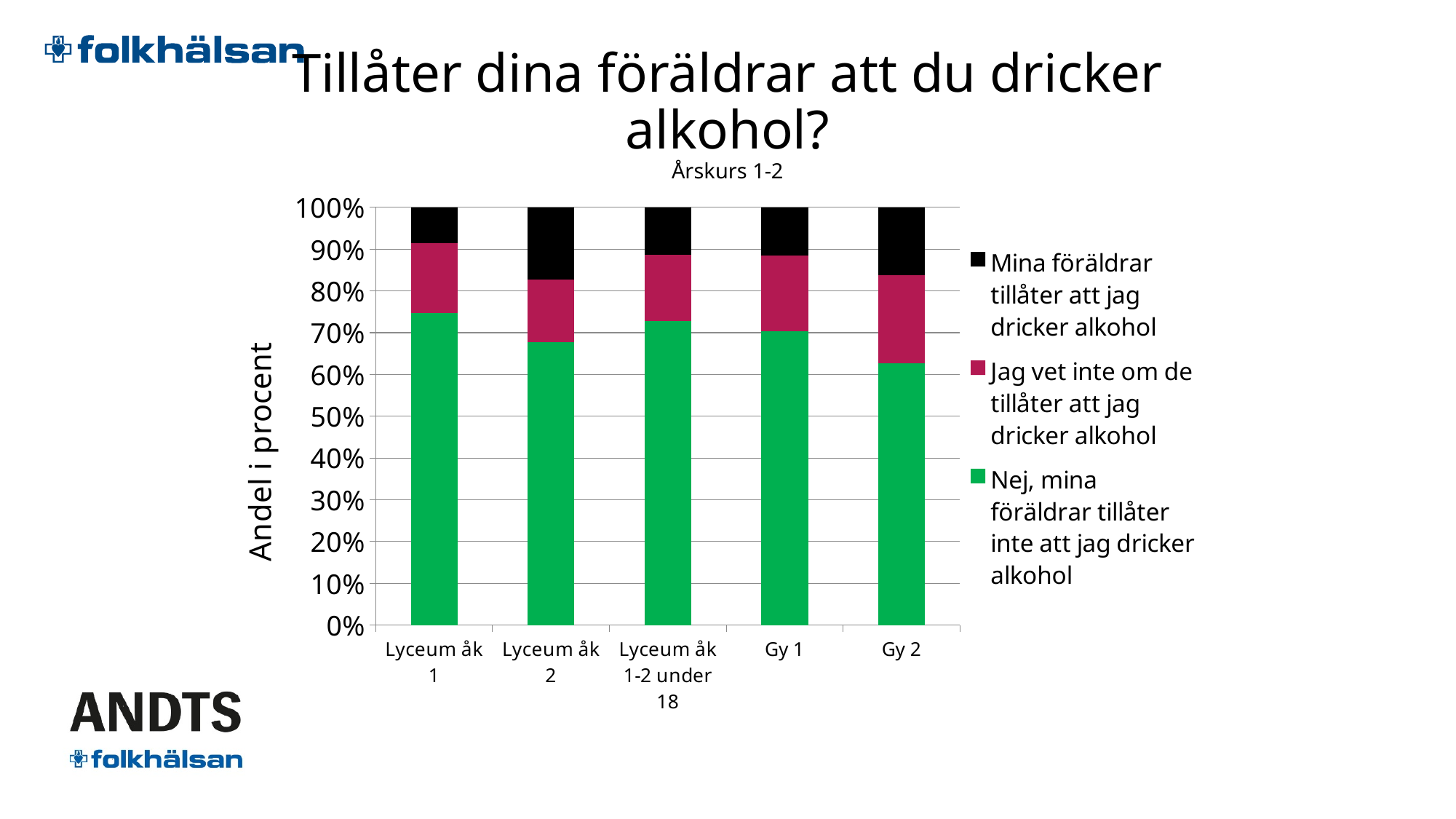
Which is larger for 'Mina föräldrar tillåter att jag dricker alkohol': Lyceum åk 1 or Lyceum åk 2? Lyceum åk 2 Is the value for 'Nej, mina föräldrar tillåter inte att jag dricker alkohol' for Lyceum åk 1 greater or less than 70%? greater What is the title of the chart (above the plot area)? Årskurs 1-2 What is the label on the vertical axis of the chart? Andel i procent How many series does the chart's legend list? 3 Which is larger for 'Nej, mina föräldrar tillåter inte att jag dricker alkohol': Lyceum åk 1 or Gy 2? Lyceum åk 1 How many categories are shown along the x axis of the chart? 5 Which category has the lowest value for 'Nej, mina föräldrar tillåter inte att jag dricker alkohol'? Gy 2 Is the value for 'Nej, mina föräldrar tillåter inte att jag dricker alkohol' for Gy 2 greater or less than 70%? less What kind of chart is shown on the slide? Stacked bar chart What is the total height of the stacked bar for Gy 1? 100% Is the value for 'Nej, mina föräldrar tillåter inte att jag dricker alkohol' for Lyceum åk 2 greater or less than 60%? greater